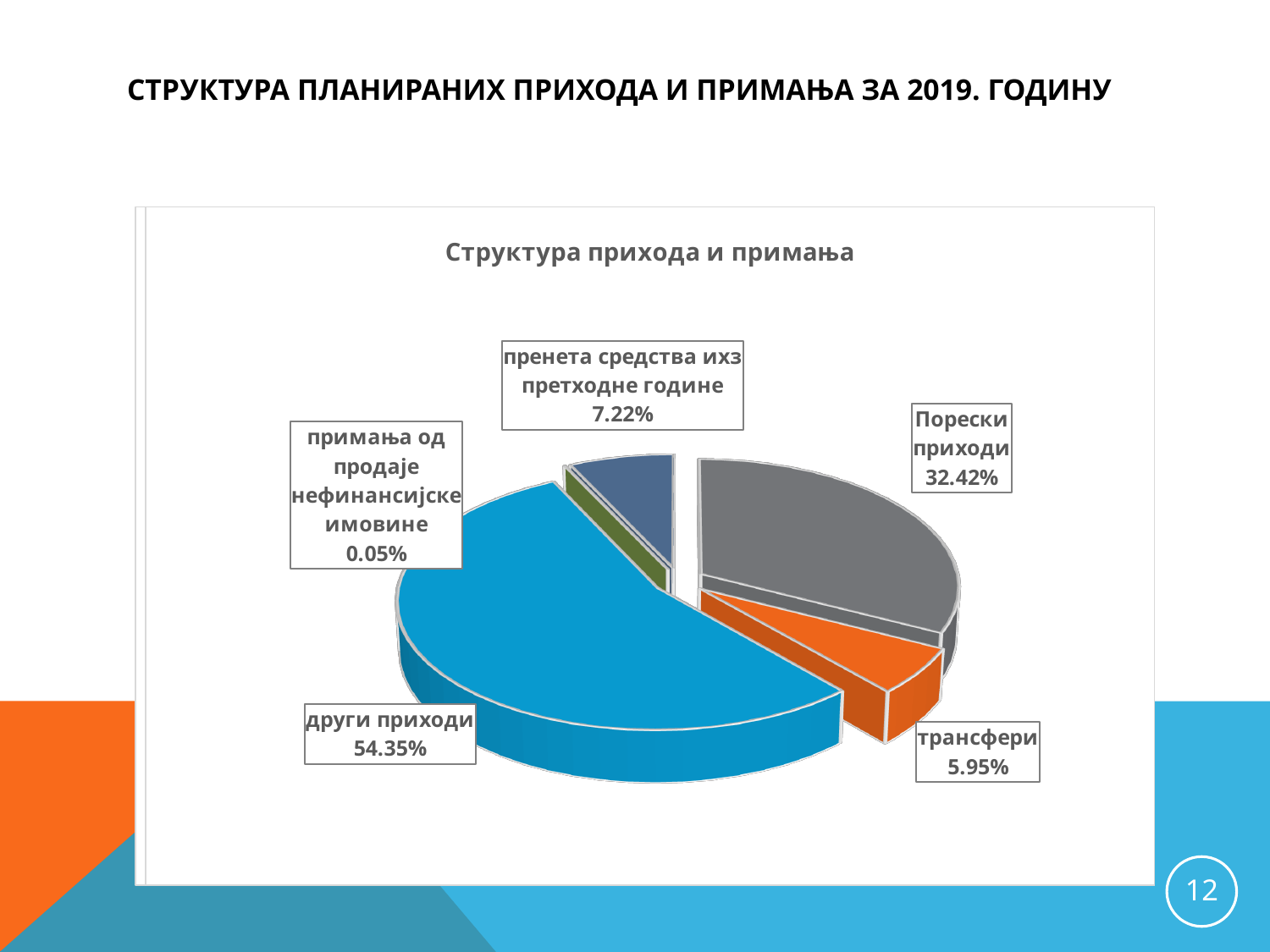
What is the difference between the shares of "други приходи" and "Порески приходи"? 21.93% What share of the pie does "Порески приходи" have? 32.42% What is the value shown for "примања од продаје нефинансијске имовине"? 0.05% What is the value shown for "пренета средства из претходне године"? 7.22% Which is larger, the share for "трансфери" or the share for "пренета средства из претходне године"? пренета средства из претходне године Which category has the largest share of the pie? други приходи What share of the pie does "други приходи" have? 54.35% Which category has the smallest share of the pie? примања од продаје нефинансијске имовине What is the value shown for "трансфери"? 5.95% What is the title of the chart? Структура прихода и примања How many slices does the pie chart have? 5 What kind of chart is shown on the slide? Pie chart